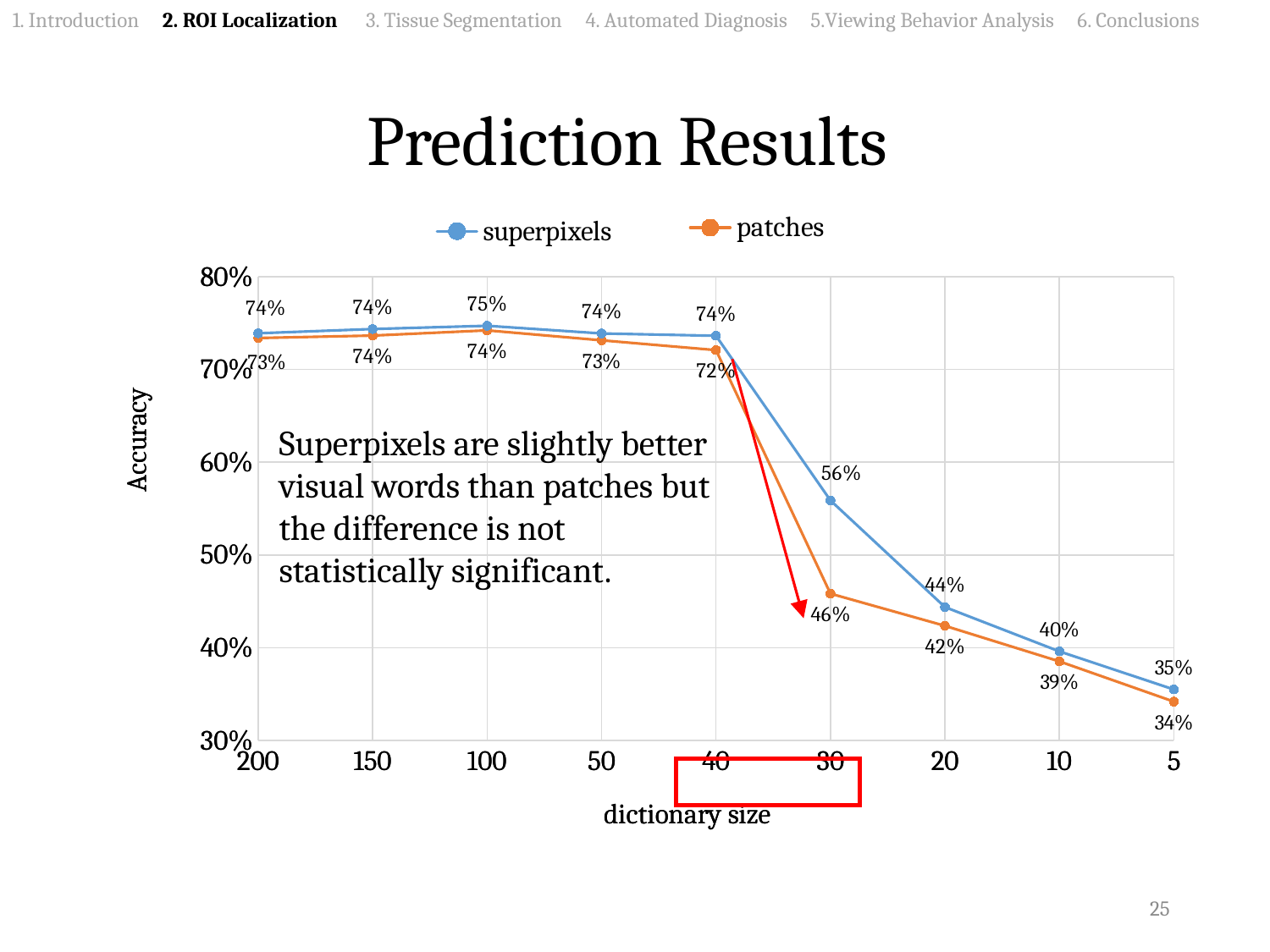
At dictionary size 20, which series has the higher accuracy, superpixels or patches? superpixels At which dictionary size does the patches series have its lowest accuracy? 5 What is the accuracy for superpixels at dictionary size 5? 35% What is the accuracy for patches at dictionary size 30? 46% What kind of chart is shown on the slide? line chart How many series does the legend list? 2 How many dictionary sizes are plotted on the x axis? 9 What is the difference between the superpixels and patches accuracy at dictionary size 30? 10% At which dictionary size does the superpixels series reach its highest accuracy? 100 What is the accuracy for patches at dictionary size 40? 72% What is the title of the chart on the slide? Prediction Results What is the accuracy for superpixels at dictionary size 100? 75%